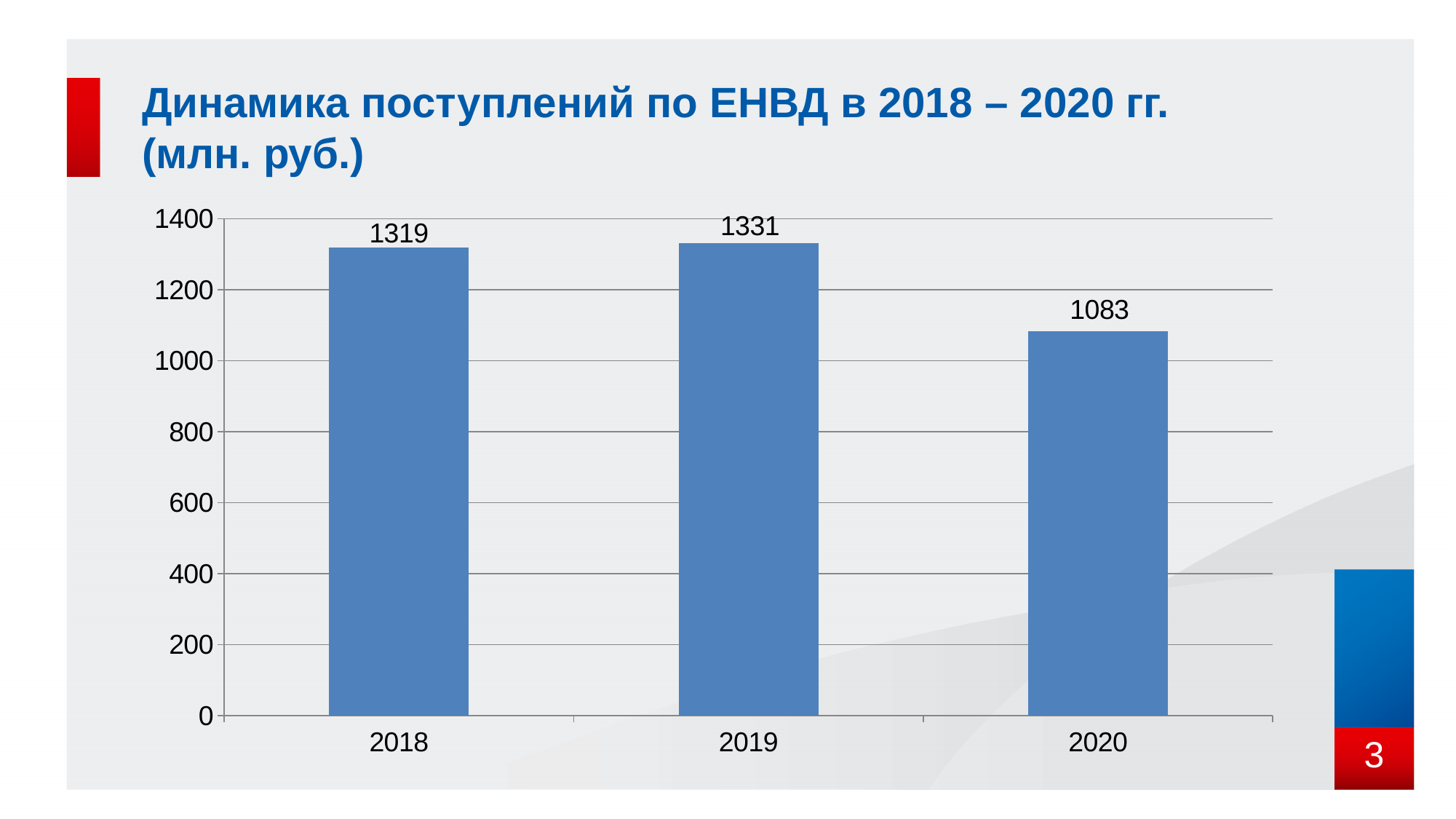
Which year has the highest value? 2019 Which year has the lowest value? 2020 What is the title of the chart? Динамика поступлений по ЕНВД в 2018 – 2020 гг. (млн. руб.) What is the value for 2019? 1331 What is the difference between the values for 2019 and 2018? 12 What is the difference between the values for 2019 and 2020? 248 Is the value for 2020 greater or less than 1200? less Which is larger, the value for 2018 or the value for 2020? 2018 What is the value for 2018? 1319 What is the value for 2020? 1083 What kind of chart is shown on the slide? bar chart How many years are shown on the x axis? 3